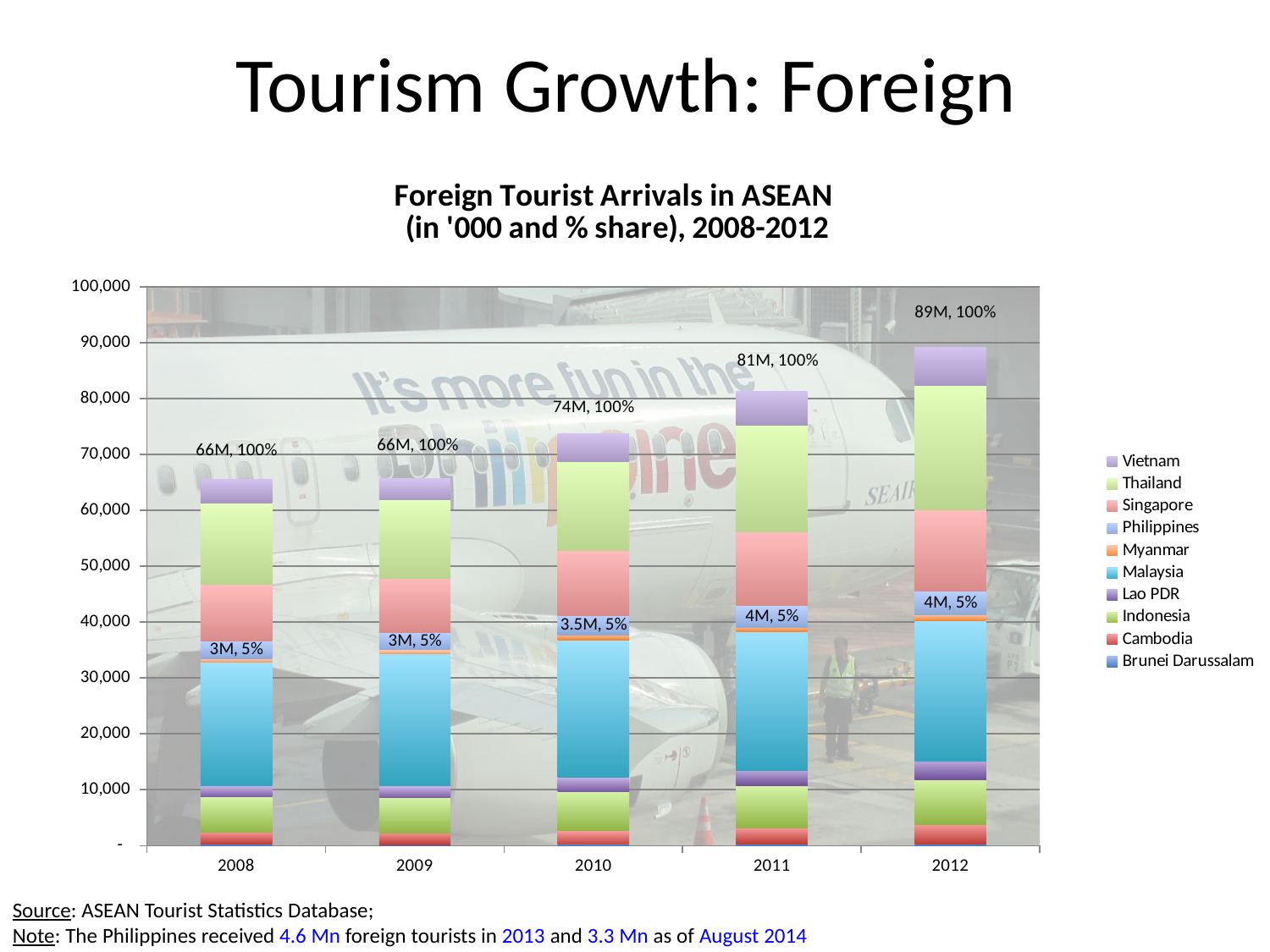
What is the title of the chart? Foreign Tourist Arrivals in ASEAN (in '000 and % share), 2008-2012 What is the total foreign tourist arrivals label for 2010? 74M, 100% Which year has the larger total foreign tourist arrivals, 2010 or 2011? 2011 What is the label shown for the Philippines in 2010? 3.5M, 5% What kind of chart is shown on the slide? Stacked bar chart What is the total foreign tourist arrivals label for 2012? 89M, 100% By how much did total foreign tourist arrivals increase from 2008 (66M) to 2012 (89M)? 23M How many years are shown on the x axis of the chart? 5 What is the label shown for the Philippines in 2011? 4M, 5% Do total foreign tourist arrivals rise or fall from 2008 to 2012? Rise How many countries does the legend list? 10 Which year has the highest total foreign tourist arrivals? 2012